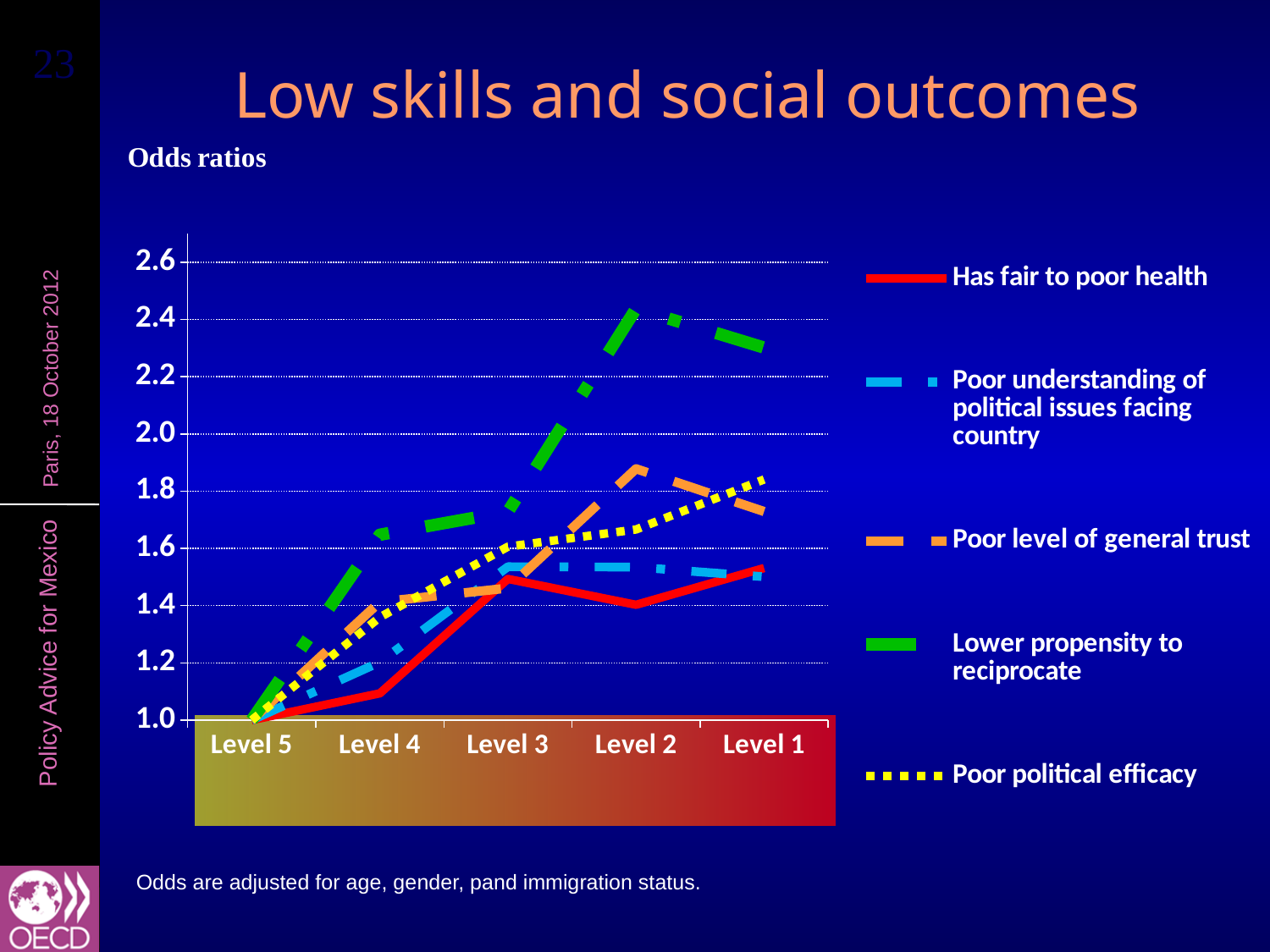
Is the value for 'Has fair to poor health' at Level 1 greater or less than 1.8? less Is the value for 'Poor political efficacy' at Level 1 greater or less than 1.6? greater Is the value for 'Lower propensity to reciprocate' at Level 2 greater or less than 2.0? greater At Level 3, which is larger: 'Lower propensity to reciprocate' or 'Has fair to poor health'? Lower propensity to reciprocate What colour is the 'Has fair to poor health' line? red Which series has the lowest value at Level 2? Has fair to poor health How many skill levels are shown on the x axis? 5 What is the odds ratio for 'Has fair to poor health' at Level 5? 1.0 Which series has the highest value at Level 2? Lower propensity to reciprocate What kind of chart is shown on the slide? line chart How many series does the legend list? 5 Does the 'Poor political efficacy' line rise or fall from Level 5 to Level 1? rise